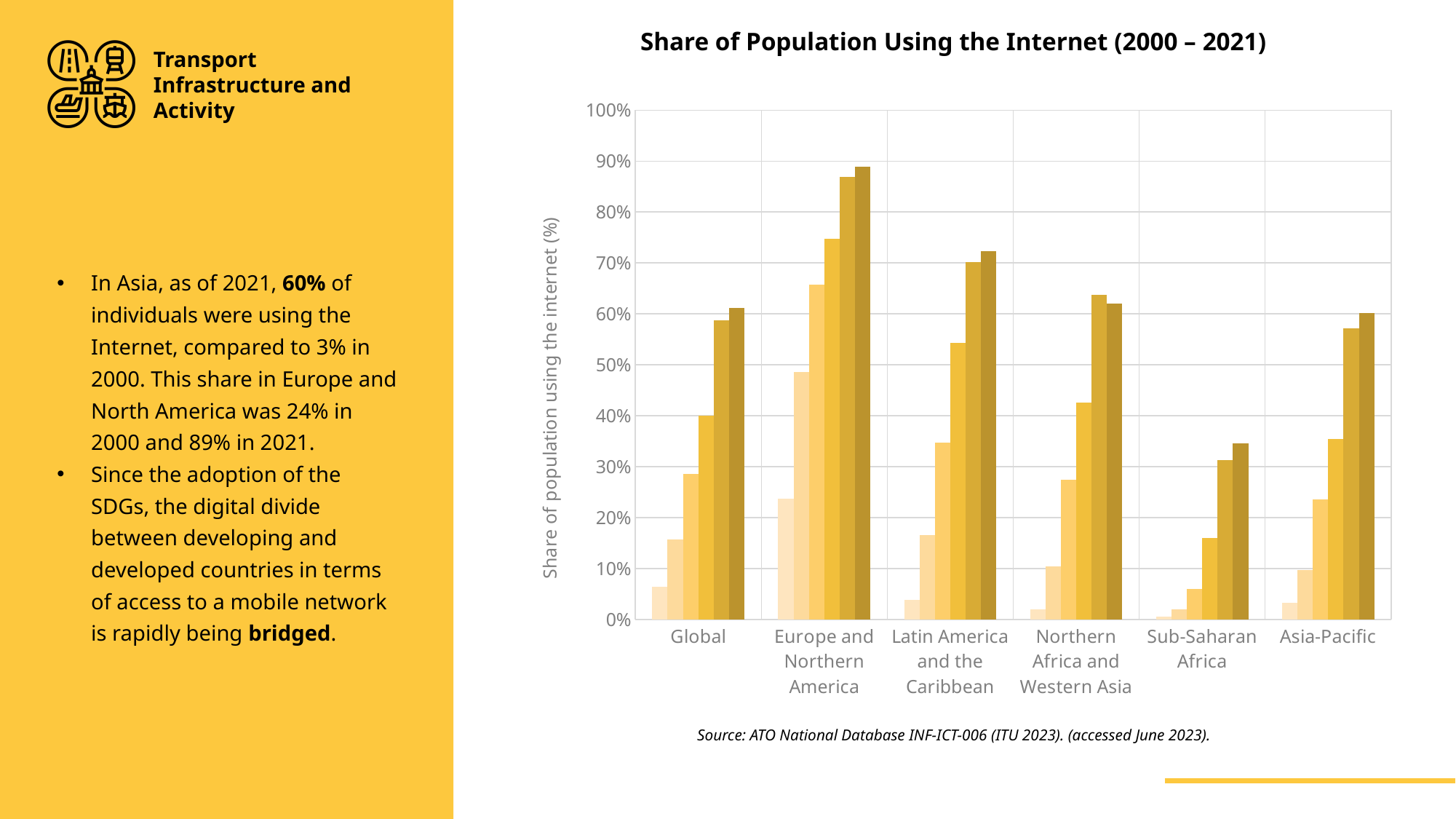
Is the shortest bar for Global greater or less than 10%? less What kind of chart is shown on the slide? bar chart Which region has a higher tallest bar: Europe and Northern America or Latin America and the Caribbean? Europe and Northern America Is the tallest bar for Northern Africa and Western Asia greater or less than 50%? greater Which region has the tallest bar in the chart? Europe and Northern America How many bars are plotted for each region in the chart? 6 Is the tallest bar for Europe and Northern America greater or less than 80%? greater Which region has the lowest tallest bar in the chart? Sub-Saharan Africa What is the title of the chart? Share of Population Using the Internet (2000 – 2021) How many regions (categories) are shown on the x axis of the chart? 6